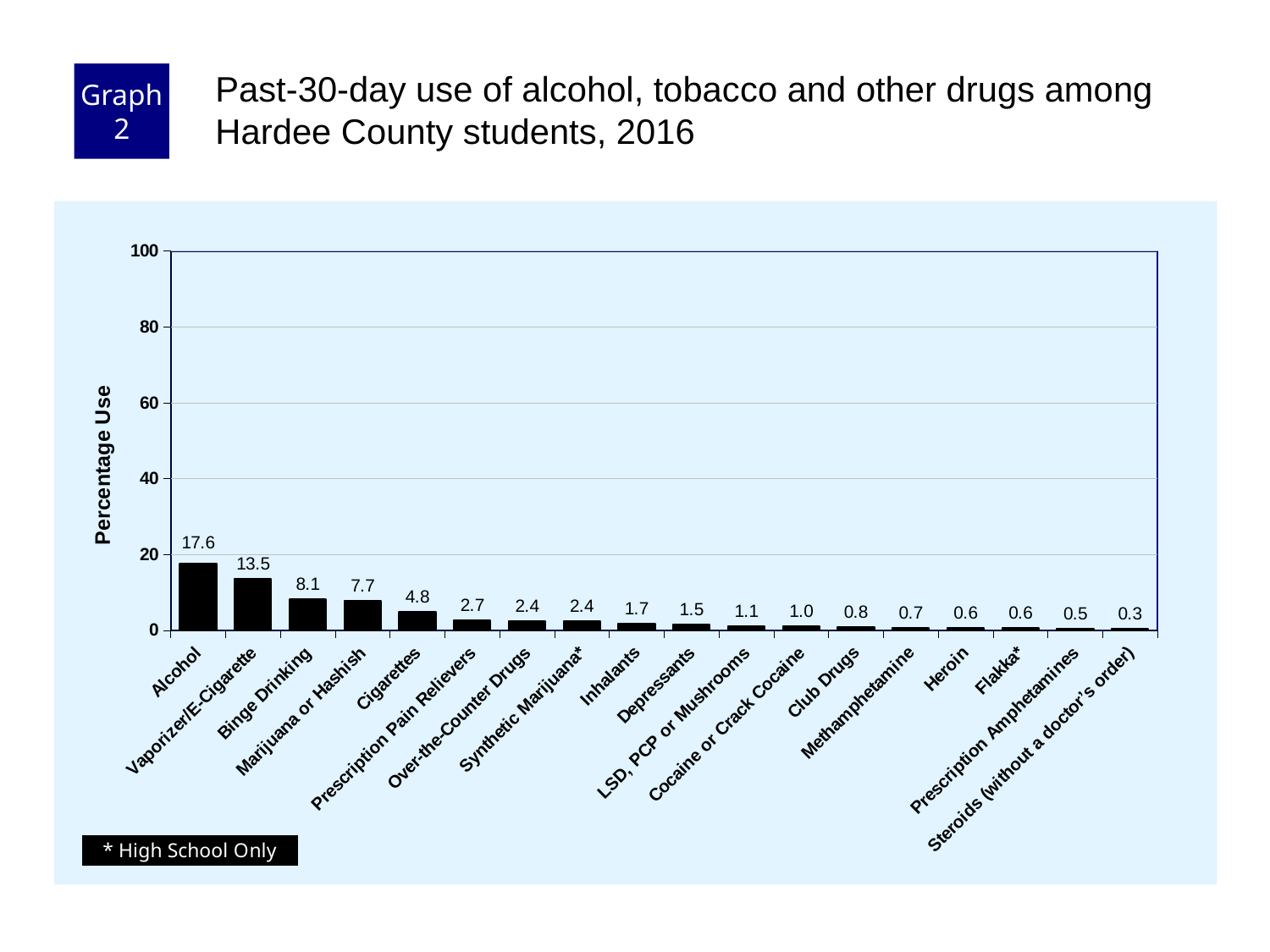
What is the percentage use for Vaporizer/E-Cigarette? 13.5 What is the percentage use for Alcohol? 17.6 What is the difference in percentage use between Alcohol and Vaporizer/E-Cigarette? 4.1 How many categories are shown on the chart? 18 What is the label on the vertical axis of the chart? Percentage Use Which category has the highest percentage use? Alcohol What is the percentage use for Cigarettes? 4.8 What kind of chart is shown on the slide? Bar chart Is the value for Alcohol greater or less than 20? less Which category has the lowest percentage use? Steroids (without a doctor's order) What is the percentage use for Inhalants? 1.7 Which has a higher percentage use, Binge Drinking or Marijuana or Hashish? Binge Drinking